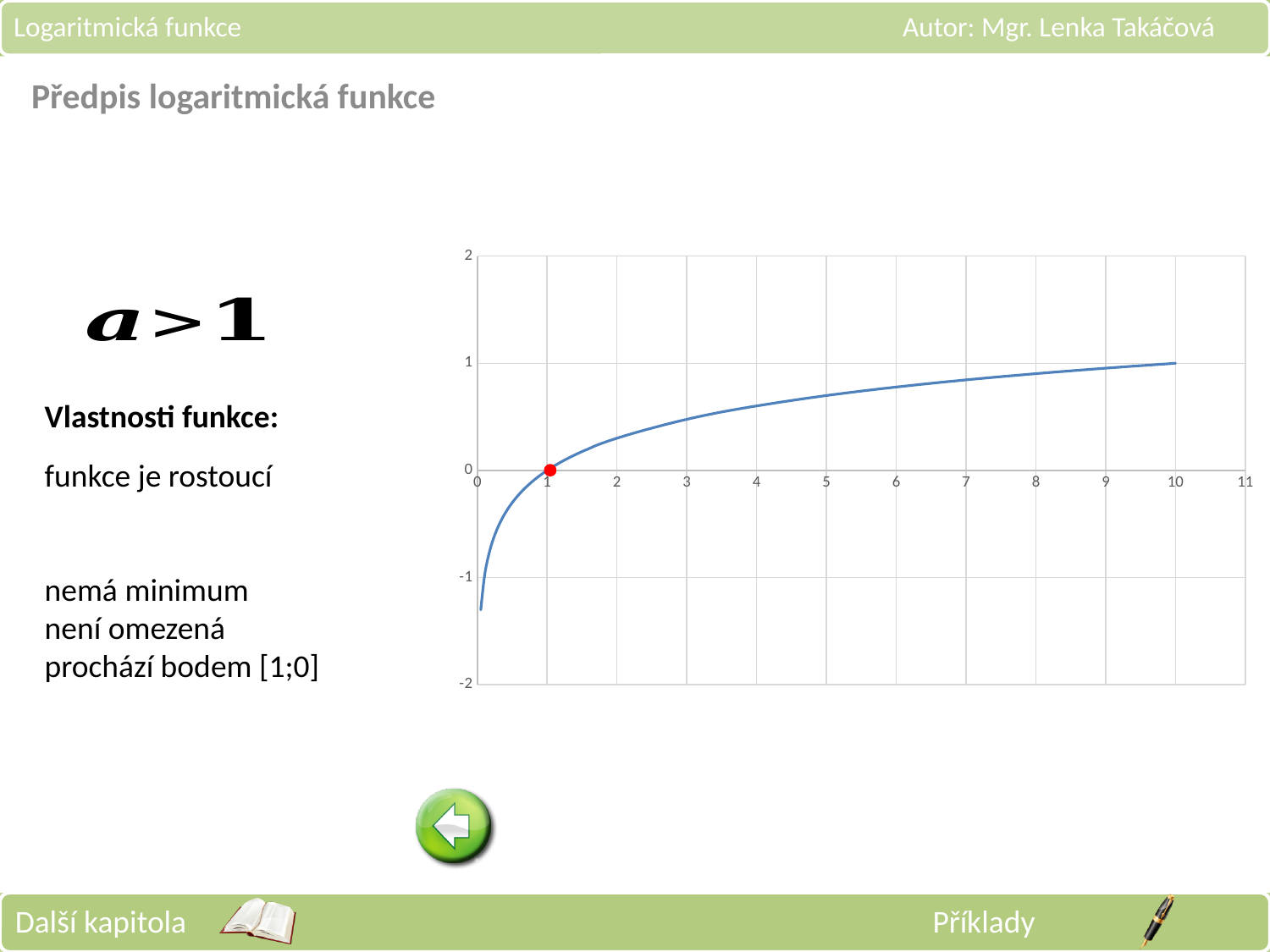
What is the highest value shown on the vertical axis? 2 What is the value of the function at x = 1, where the red point is marked? 0 Is the value of the function at x = 5 greater or less than 1? less Which is larger, the value of the function at x = 3 or at x = 8? x = 8 Is the value of the function at x = 0.5 greater or less than 0? less What is the highest value shown on the horizontal axis? 11 Do the values of the plotted function rise or fall as x increases? rise Is the value of the function at x = 2 greater or less than 1? less What kind of chart is shown on the slide? line chart At which point does the red marker on the curve lie, according to the slide? [1;0] What is the value of the function at x = 10, the right end of the curve? 1